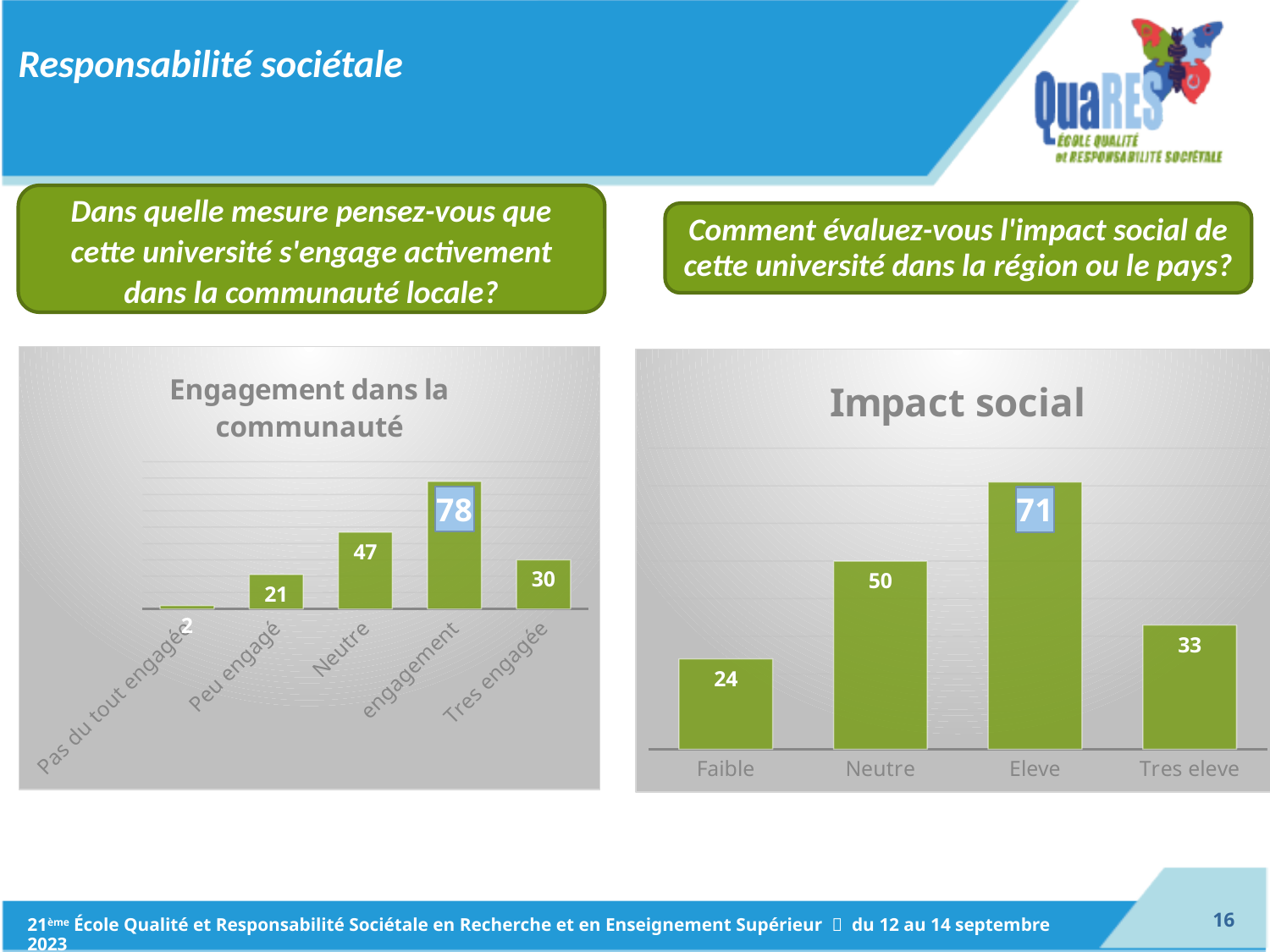
What type of chart is the 'Impact social' chart? Bar chart In the 'Engagement dans la communauté' chart, which category has the highest value? engagement In the 'Engagement dans la communauté' chart, which is larger, the value for Peu engagé or the value for Tres engagée? Tres engagée In the 'Impact social' chart, how many categories are shown? 4 In the 'Impact social' chart, which category has the highest value? Eleve In the 'Engagement dans la communauté' chart, what is the value for Tres engagée? 30 In the 'Engagement dans la communauté' chart, what is the difference between the values for engagement and Neutre? 31 In the 'Impact social' chart, what is the value for Faible? 24 In the 'Impact social' chart, what is the difference between the values for Eleve and Tres eleve? 38 In the 'Impact social' chart, which category has the lowest value? Faible In the 'Impact social' chart, what is the value for Neutre? 50 In the 'Engagement dans la communauté' chart, what is the value for Neutre? 47